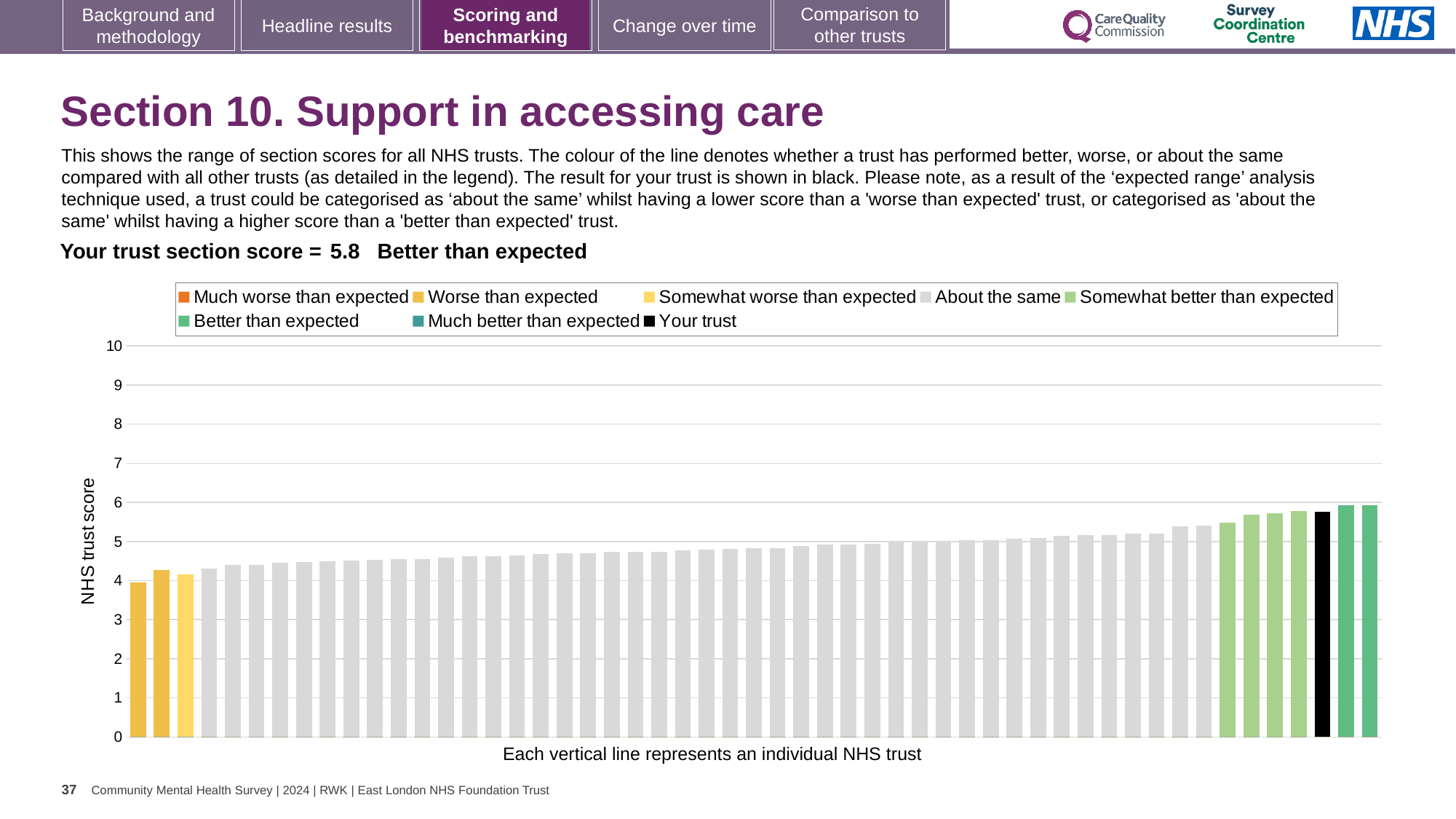
What is the label on the vertical axis of the chart? NHS trust score What does the black bar in the chart represent? Your trust What kind of chart is shown on the slide? bar chart How many bars are coloured as 'Somewhat better than expected' (light green)? 4 Is the leftmost bar higher or lower than the rightmost bar? lower How many entries does the chart legend list? 8 What is the section score for your trust shown on the slide? 5.8 Is the value of the black bar (your trust) greater or less than 5? greater Is the value of the leftmost bar greater or less than 5? less Do the bar values rise or fall from left to right across the chart? rise How is your trust's section score categorised compared with other trusts? Better than expected